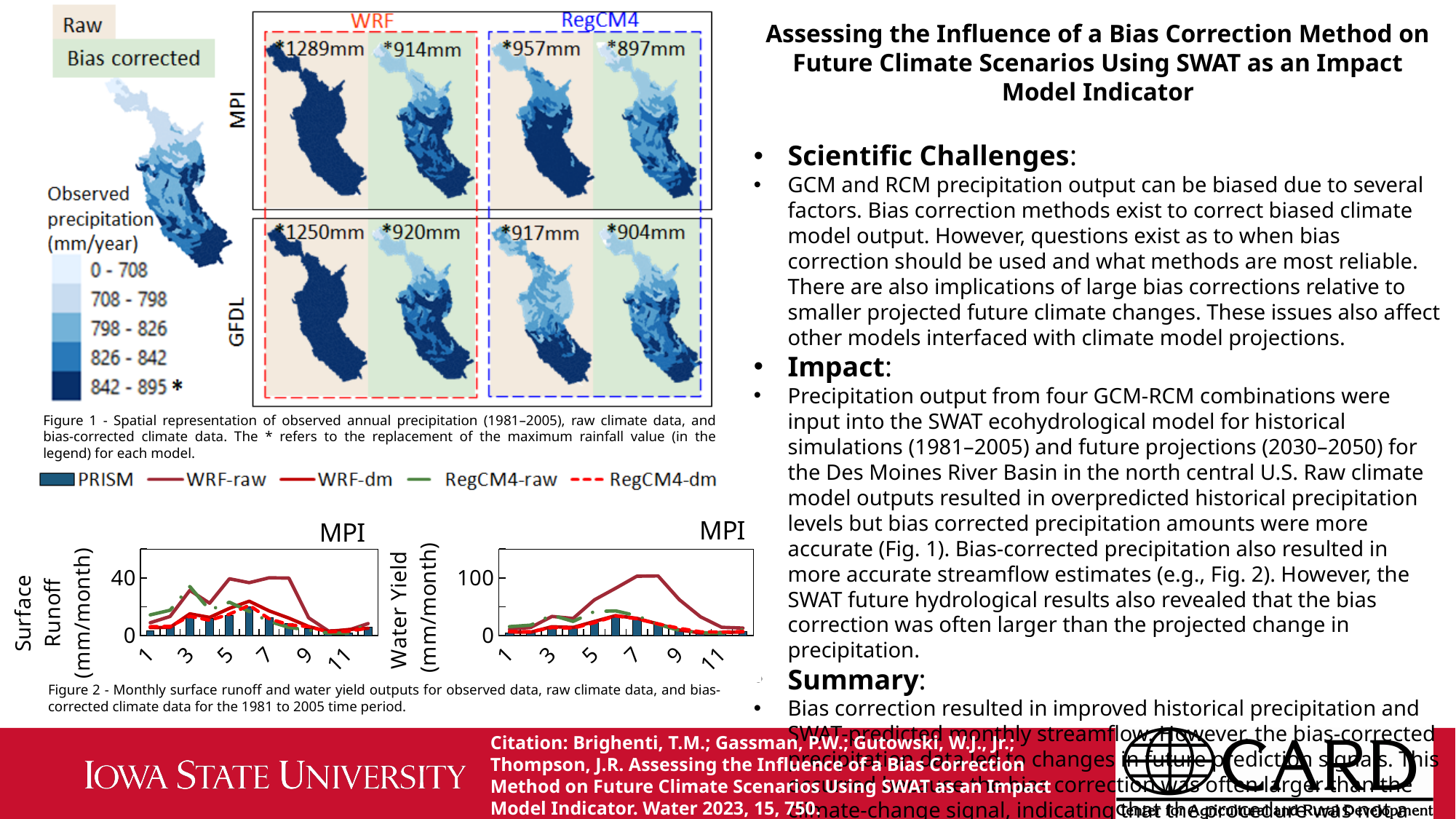
In the Water Yield chart of Figure 2, is the PRISM value at month 6 greater or less than 100? less In Figure 1, what is the difference between the MPI WRF raw and MPI WRF bias-corrected maximum rainfall values? 375mm In Figure 1, which is larger: the RegCM4 raw maximum rainfall value for MPI or for GFDL? MPI (*957mm) In the Figure 2 legend, which series is drawn as a dashed red line? RegCM4-dm In Figure 1, what is the maximum rainfall value shown for the GFDL RegCM4 bias-corrected map? *904mm In the Water Yield chart of Figure 2, does the WRF-raw line rise or fall from month 1 to month 7? rise In the Surface Runoff chart of Figure 2, is the PRISM value at month 6 greater or less than 40? less In Figure 1, which map has the highest maximum rainfall value? MPI WRF raw (*1289mm) In Figure 1, which map has the lowest maximum rainfall value? MPI RegCM4 bias corrected (*897mm) In Figure 1, what is the difference between the GFDL WRF raw and GFDL WRF bias-corrected maximum rainfall values? 330mm How many series does the legend for Figure 2 list? 5 In Figure 1, what is the maximum rainfall value shown for the MPI WRF raw map? *1289mm